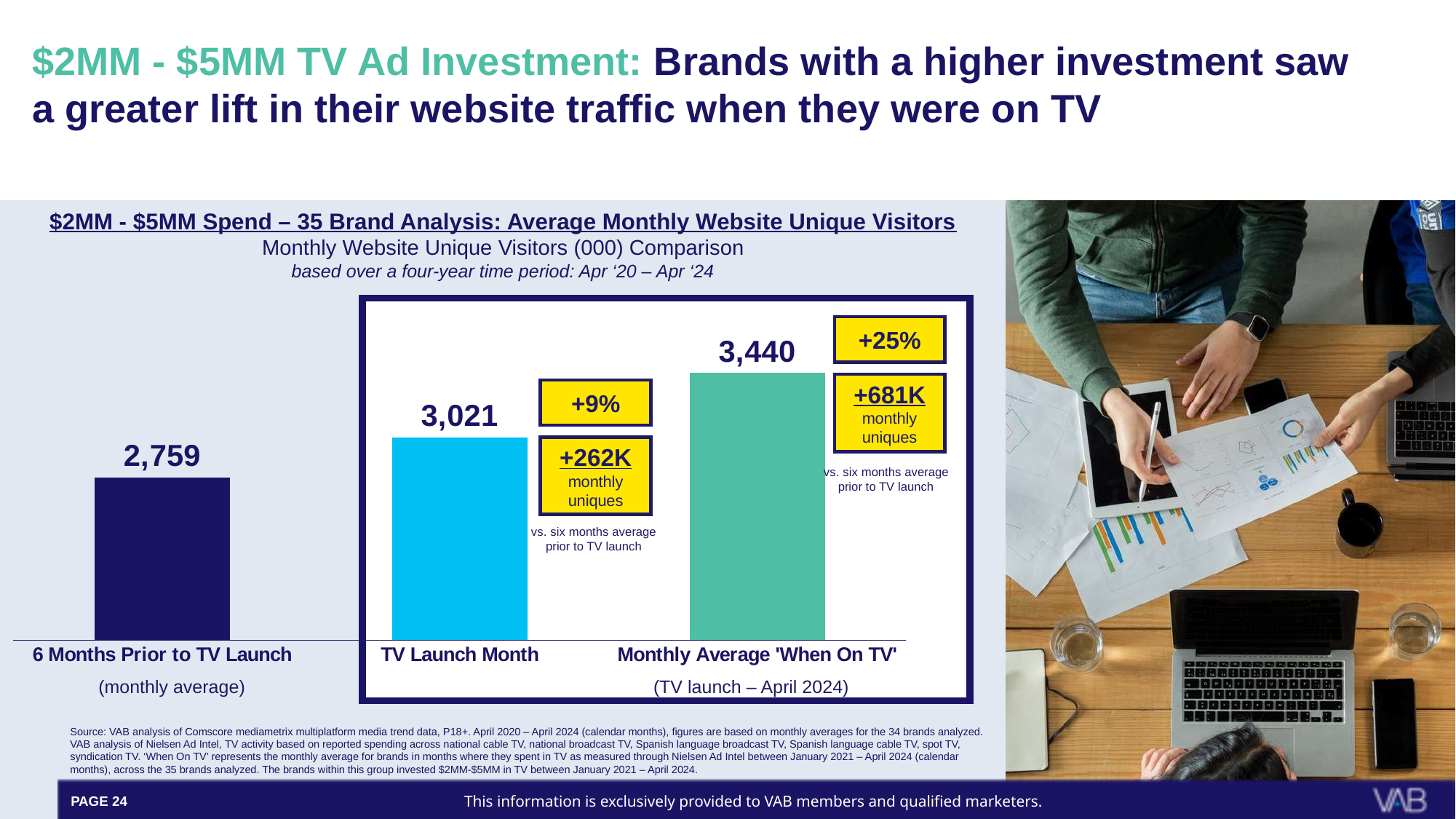
What percentage lift is shown in the callout next to the 'Monthly Average 'When On TV'' bar? +25% Which category has the highest value? Monthly Average 'When On TV' What kind of chart is shown on the slide? Bar chart Do the values rise or fall from left to right across the chart? Rise What is the value for 'TV Launch Month'? 3,021 What is the value for '6 Months Prior to TV Launch'? 2,759 What is the difference between the 'TV Launch Month' value and the '6 Months Prior to TV Launch' value? 262 Which category has the lowest value? 6 Months Prior to TV Launch What is the value for 'Monthly Average 'When On TV''? 3,440 How many bars are shown in the chart? 3 Which is larger, the value for 'TV Launch Month' or the value for 'Monthly Average 'When On TV''? Monthly Average 'When On TV' What is the difference between the 'Monthly Average 'When On TV'' value and the '6 Months Prior to TV Launch' value? 681